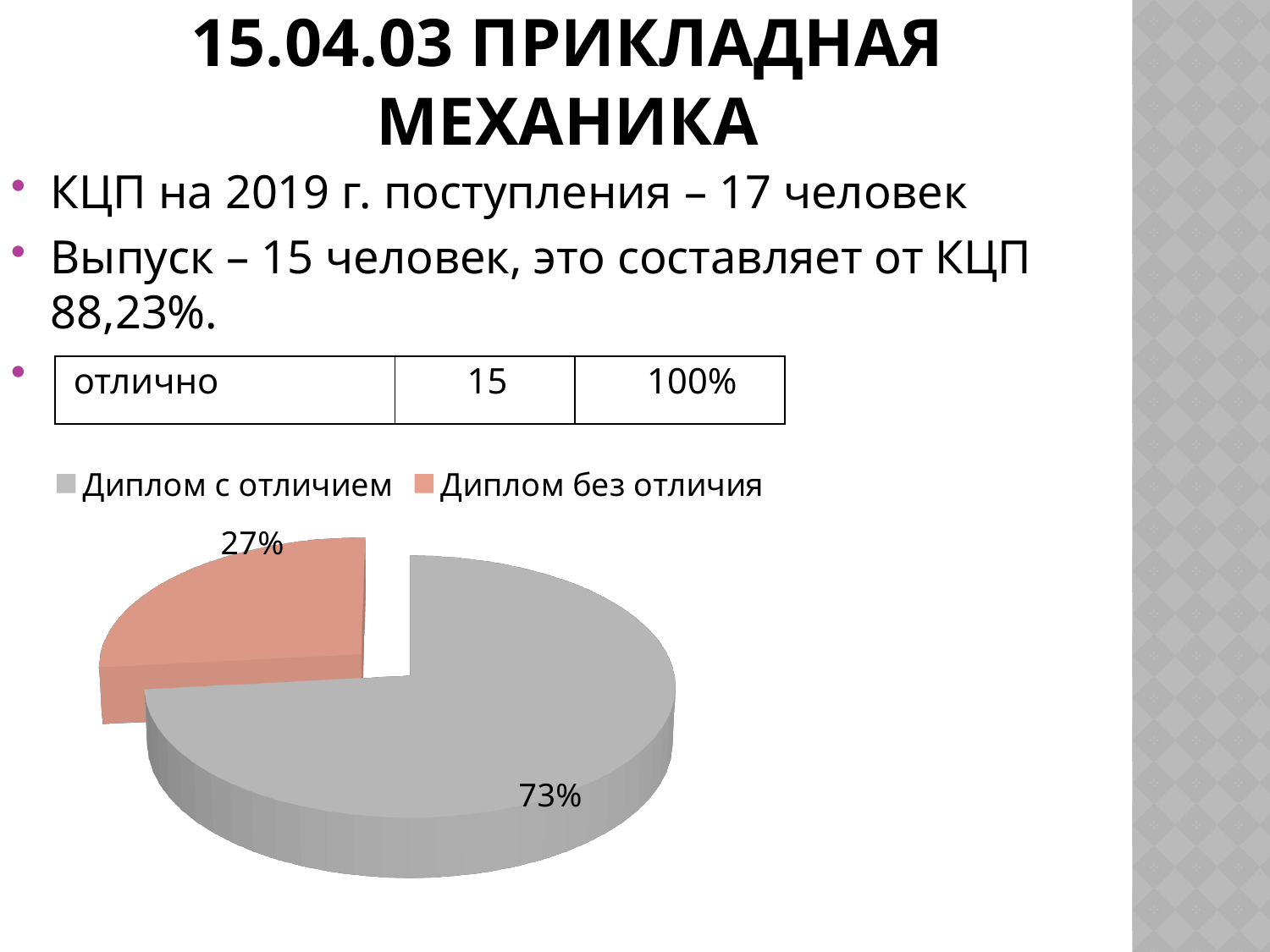
What share of the pie does "Диплом с отличием" have? 73% What share of the pie does "Диплом без отличия" have? 27% How many slices does the pie chart have? 2 Which slice of the pie is the largest? Диплом с отличием What is the difference in percentage points between the "Диплом с отличием" and "Диплом без отличия" slices? 46 Which slice of the pie is the smallest? Диплом без отличия What colour is the "Диплом с отличием" slice? grey What colour is the "Диплом без отличия" slice? pink (salmon) What kind of chart is shown on the slide? pie chart How many entries does the legend list? 2 Which is larger: the "Диплом с отличием" slice or the "Диплом без отличия" slice? Диплом с отличием